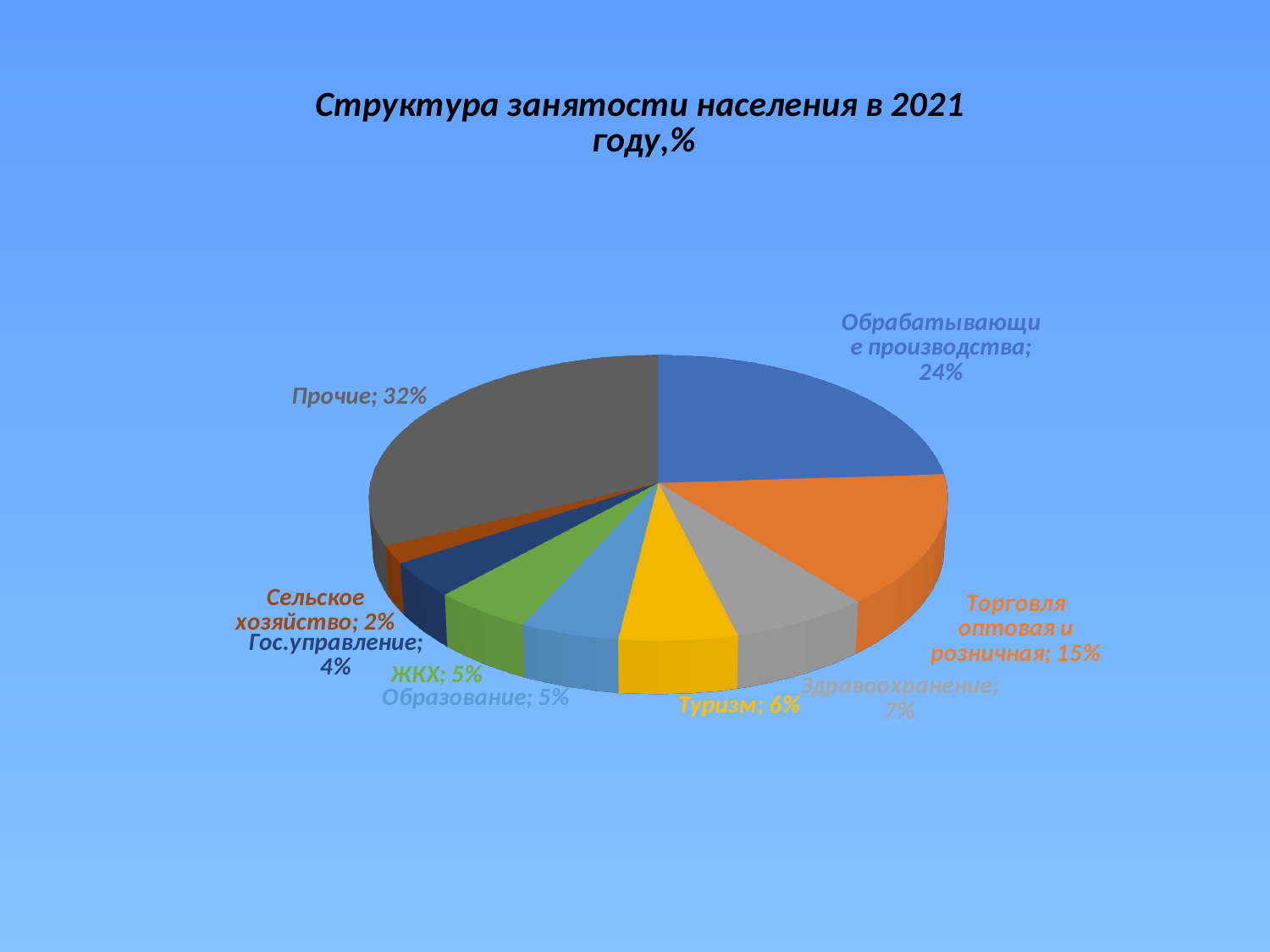
Как называется диаграмма на слайде? Структура занятости населения в 2021 году,% Какова доля сектора «Торговля оптовая и розничная»? 15% Какова сумма долей секторов «Образование» и «ЖКХ»? 10% Что больше: доля «Туризм» или доля «Гос.управление»? Туризм На сколько процентных пунктов доля «Обрабатывающие производства» больше доли «Торговля оптовая и розничная»? 9 Сколько секторов показано на диаграмме? 9 Какова доля сектора «Сельское хозяйство»? 2% Какой сектор имеет наибольшую долю? Прочие Какова доля сектора «Обрабатывающие производства»? 24% Какой сектор имеет наименьшую долю? Сельское хозяйство Какой тип диаграммы показан на слайде? Круговая диаграмма Какова доля сектора «Здравоохранение»? 7%